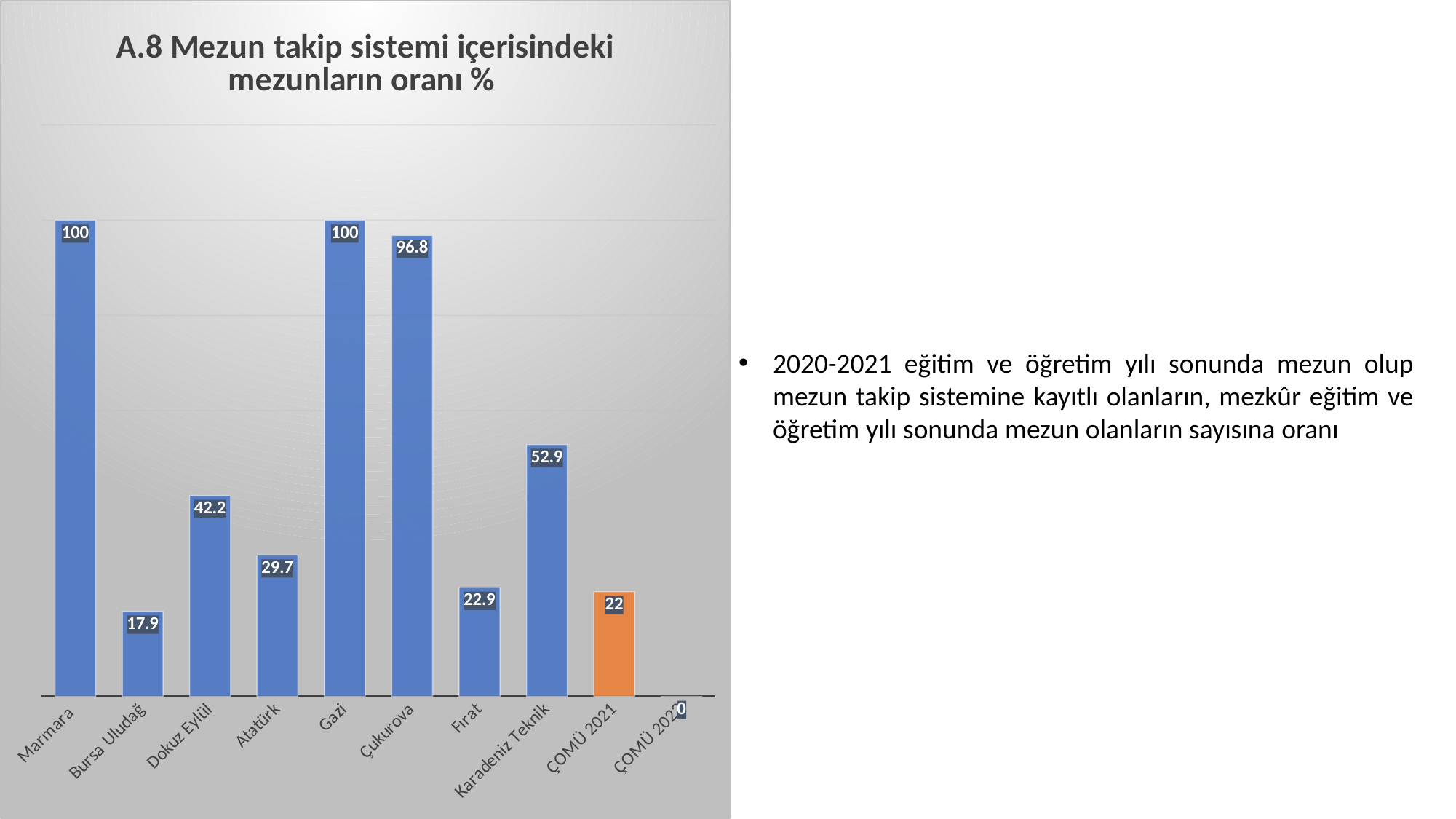
What is the value for ÇOMÜ 2021? 22 What is the difference between the values for Gazi and Çukurova? 3.2 What is the value for Bursa Uludağ? 17.9 What type of chart is shown on the slide? bar chart What is the value for Marmara? 100 Which is larger, the value for Dokuz Eylül or the value for Atatürk? Dokuz Eylül What is the difference between the values for Karadeniz Teknik and Fırat? 30 What value is shown for the rightmost bar in the chart? 0 Which bar in the chart is coloured orange rather than blue? ÇOMÜ 2021 What is the value for Çukurova? 96.8 How many categories are shown on the x axis of the chart? 10 What is the value for Karadeniz Teknik? 52.9